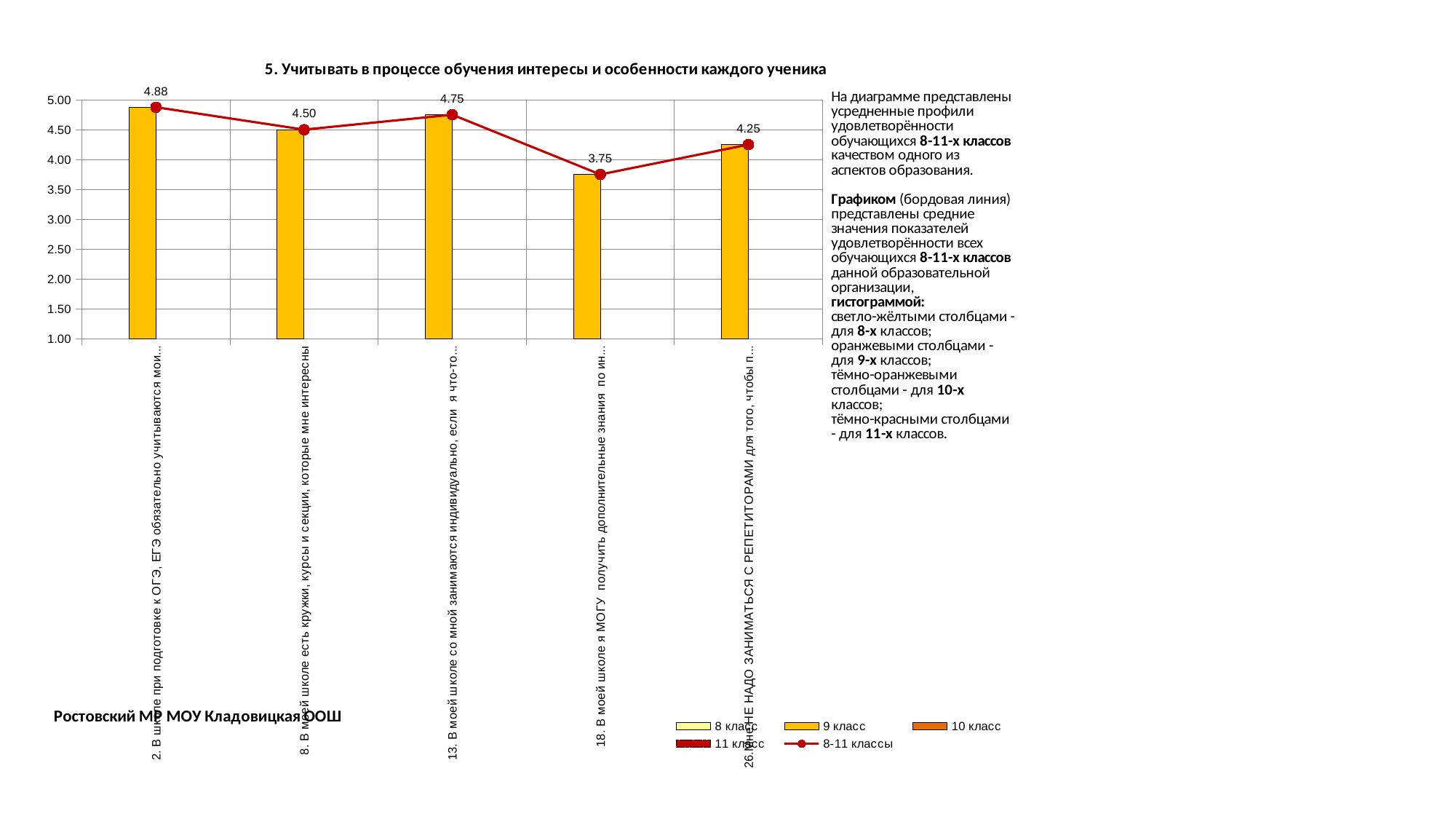
Is the value for statement 18 greater or less than 4.00? less How many statements (categories) are plotted on the chart? 5 What is the difference between the values for statement 2 and statement 18? 1.13 Which statement has the highest value on the chart? 2. В школе при подготовке к ОГЭ, ЕГЭ обязательно учитываются мои... How many series does the legend list? 5 What is the title of the chart? 5. Учитывать в процессе обучения интересы и особенности каждого ученика What is the value shown for statement 8 ("В моей школе есть кружки, курсы и секции, которые мне интересны")? 4.50 What kind of chart is shown on the slide? A combined bar and line chart Which statement has the lowest value on the chart? 18. В моей школе я МОГУ получить дополнительные знания по ин... What is the value shown for statement 18 ("В моей школе я МОГУ получить дополнительные знания...")? 3.75 Which has the larger value: statement 13 or statement 26? Statement 13 What is the value shown for statement 26 ("МНЕ НАДО ЗАНИМАТЬСЯ С РЕПЕТИТОРАМИ...")? 4.25